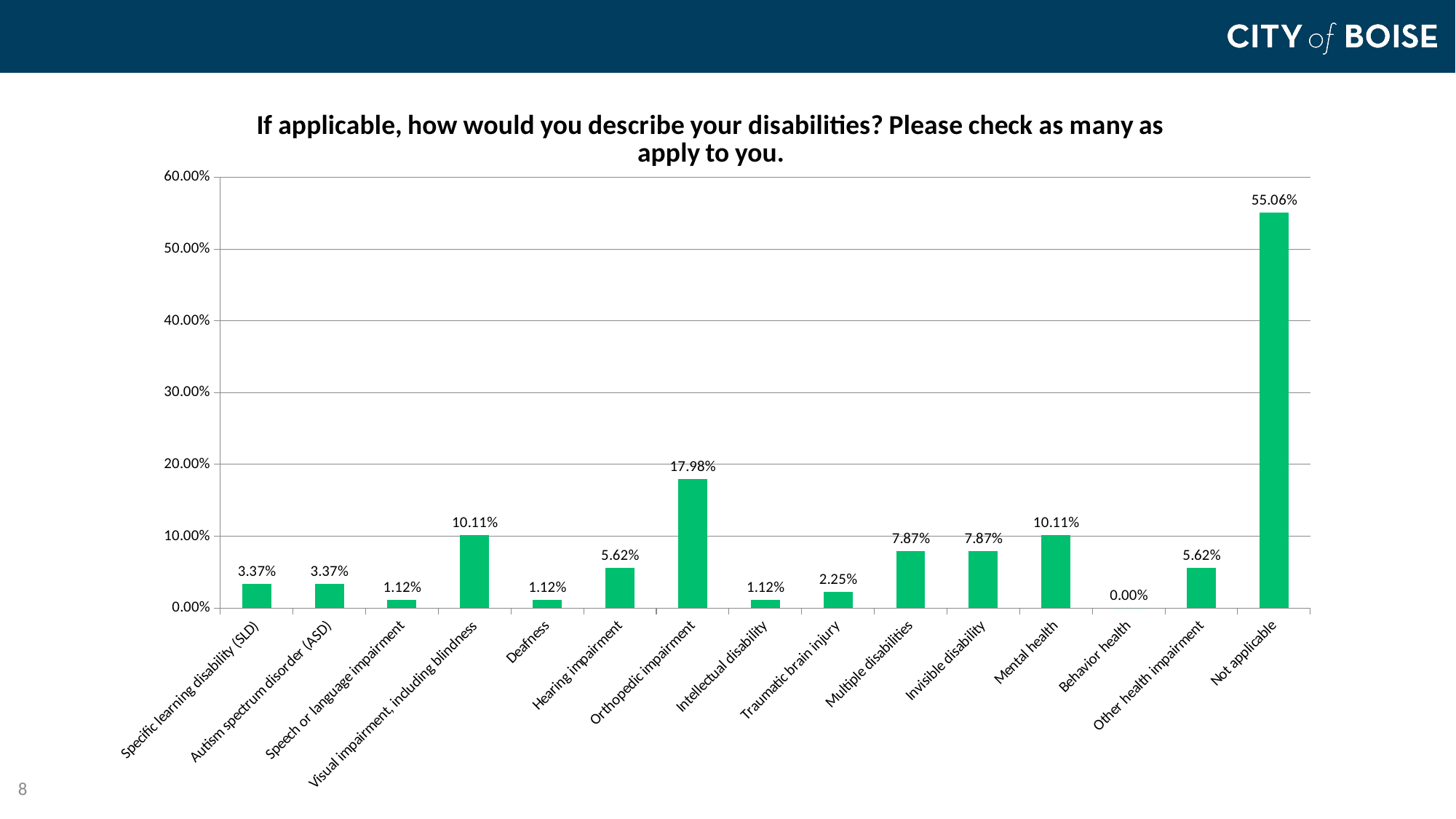
What is the value for Not applicable? 55.06% What is the value for Orthopedic impairment? 17.98% Which is larger, Hearing impairment or Multiple disabilities? Multiple disabilities What kind of chart is this? Bar chart What is the value for Traumatic brain injury? 2.25% How many categories are shown on the x axis? 15 Is the value for Orthopedic impairment greater or less than 20.00%? less What is the title of the chart? If applicable, how would you describe your disabilities? Please check as many as apply to you. What is the difference between Not applicable and Orthopedic impairment? 37.08% What is the value for Behavior health? 0.00% Which category has the highest value? Not applicable Which category has the lowest value? Behavior health